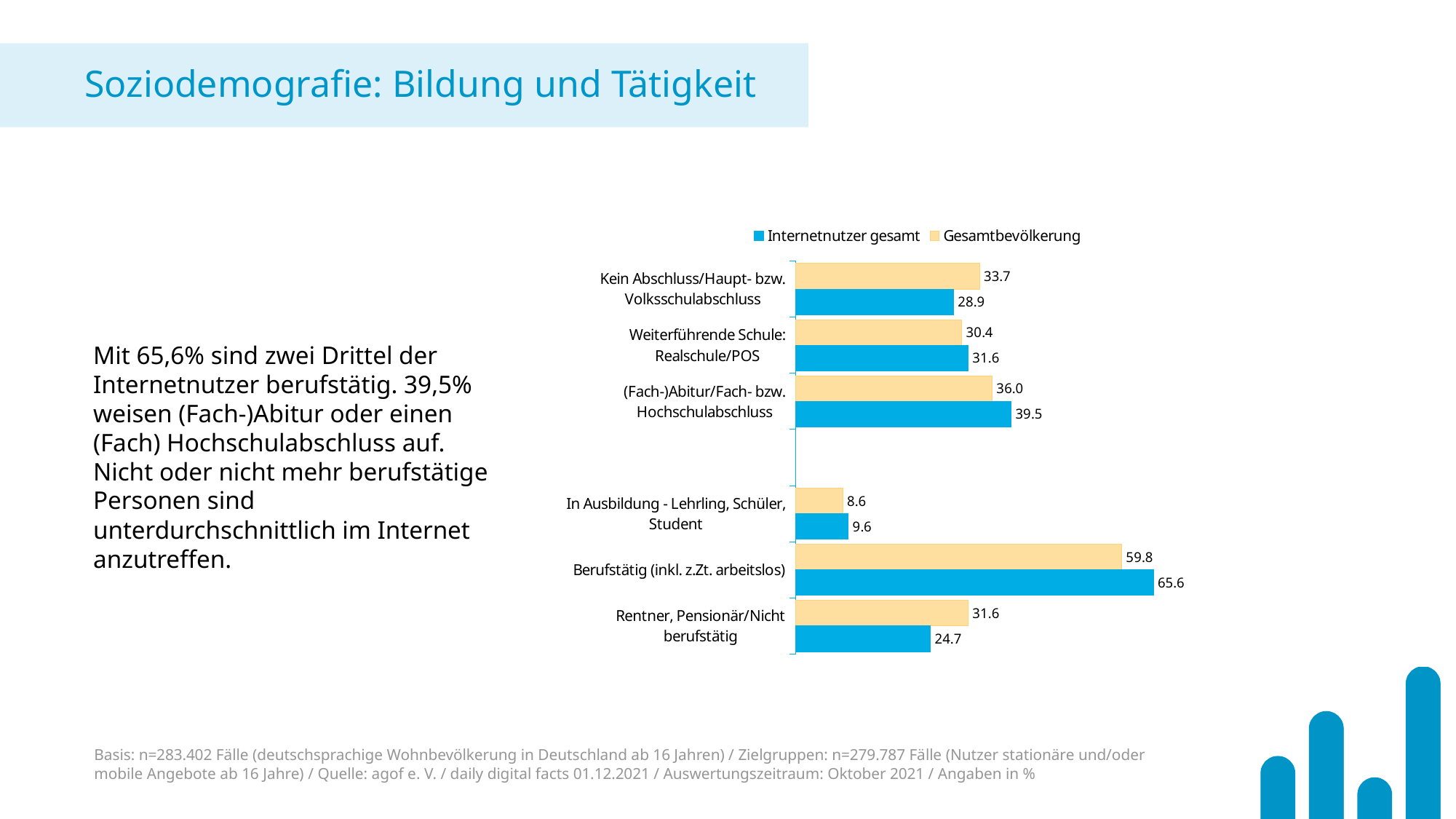
What is the value for Internetnutzer gesamt in the category Rentner, Pensionär/Nicht berufstätig? 24.7 What is the value for Gesamtbevölkerung in the category Kein Abschluss/Haupt- bzw. Volksschulabschluss? 33.7 What is the difference between Gesamtbevölkerung and Internetnutzer gesamt in the category (Fach-)Abitur/Fach- bzw. Hochschulabschluss? 3.5 What is the difference between Internetnutzer gesamt and Gesamtbevölkerung in the category Berufstätig (inkl. z.Zt. arbeitslos)? 5.8 In the category Rentner, Pensionär/Nicht berufstätig, which series has the larger value, Internetnutzer gesamt or Gesamtbevölkerung? Gesamtbevölkerung What is the value for Gesamtbevölkerung in the category In Ausbildung - Lehrling, Schüler, Student? 8.6 Which category has the highest value for Internetnutzer gesamt? Berufstätig (inkl. z.Zt. arbeitslos) What is the value for Internetnutzer gesamt in the category Berufstätig (inkl. z.Zt. arbeitslos)? 65.6 What kind of chart is shown on the slide? bar chart How many series does the legend list? 2 Which colour represents the series Gesamtbevölkerung in the chart? yellow Which category has the lowest value for Gesamtbevölkerung? In Ausbildung - Lehrling, Schüler, Student